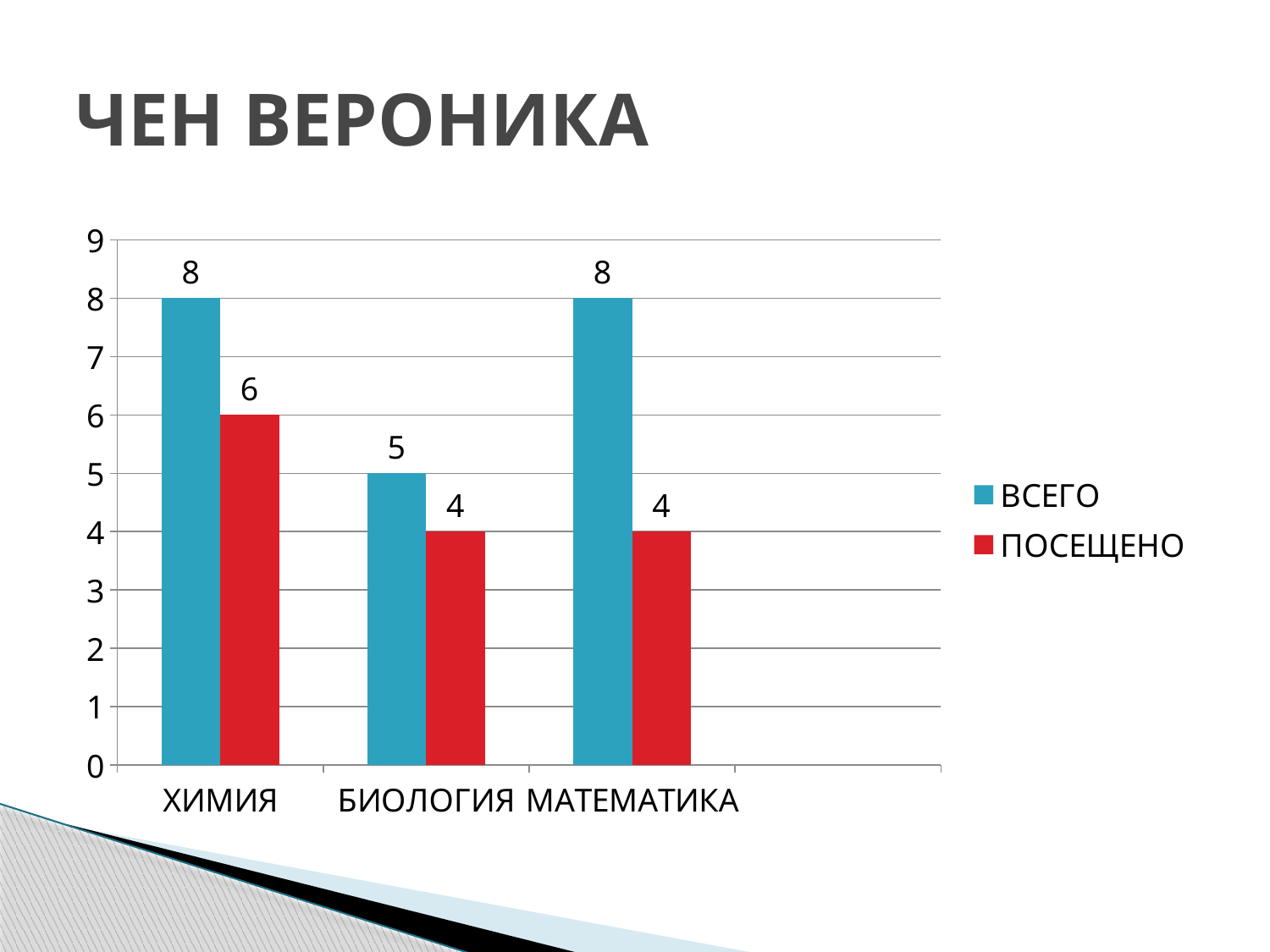
What is the ПОСЕЩЕНО value for ХИМИЯ? 6 Which category has the lowest ВСЕГО value? БИОЛОГИЯ How many categories are shown on the x axis? 3 Which is larger, the ВСЕГО value for БИОЛОГИЯ or the ПОСЕЩЕНО value for ХИМИЯ? ПОСЕЩЕНО value for ХИМИЯ What is the difference between ВСЕГО and ПОСЕЩЕНО for ХИМИЯ? 2 What kind of chart is shown on the slide? bar chart What is the ПОСЕЩЕНО value for БИОЛОГИЯ? 4 What is the ВСЕГО value for МАТЕМАТИКА? 8 How many series does the legend list? 2 What is the difference between ВСЕГО and ПОСЕЩЕНО for МАТЕМАТИКА? 4 Which category has the highest ПОСЕЩЕНО value? ХИМИЯ What is the ВСЕГО value for ХИМИЯ? 8